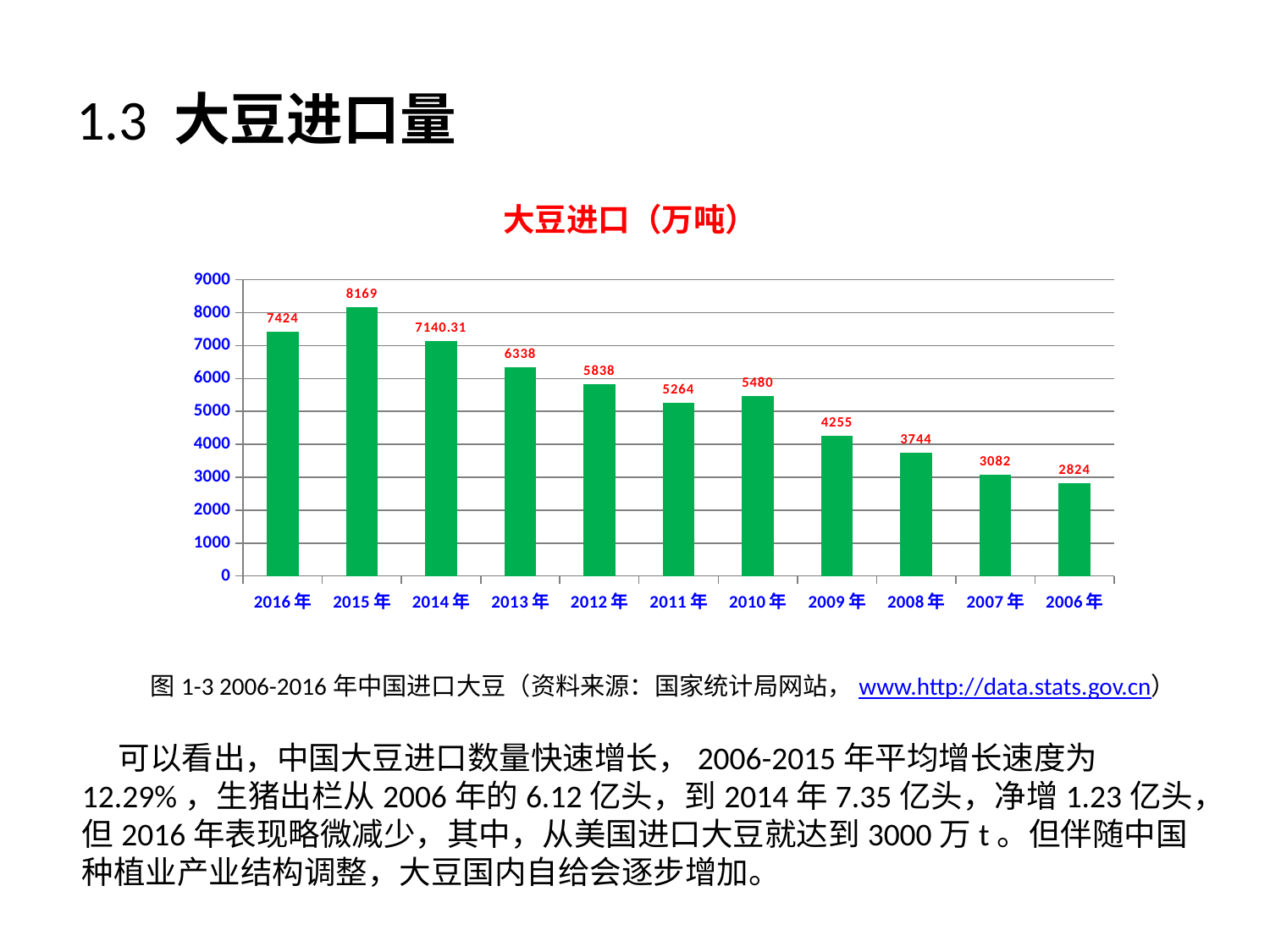
What is the title of the chart? 大豆进口（万吨） Is the value for 2012年 greater or less than 5000? greater Which year has the highest soybean import value? 2015年 What kind of chart is shown on the slide? bar chart Which year has the lowest soybean import value? 2006年 What is the difference between the soybean import values for 2015年 and 2016年? 745 Which is larger, the soybean import value for 2011年 or for 2010年? 2010年 What is the soybean import value for 2015年? 8169 What is the difference between the soybean import values for 2010年 and 2009年? 1225 What is the soybean import value for 2014年? 7140.31 What is the soybean import value for 2006年? 2824 How many years are shown on the x axis of the chart? 11